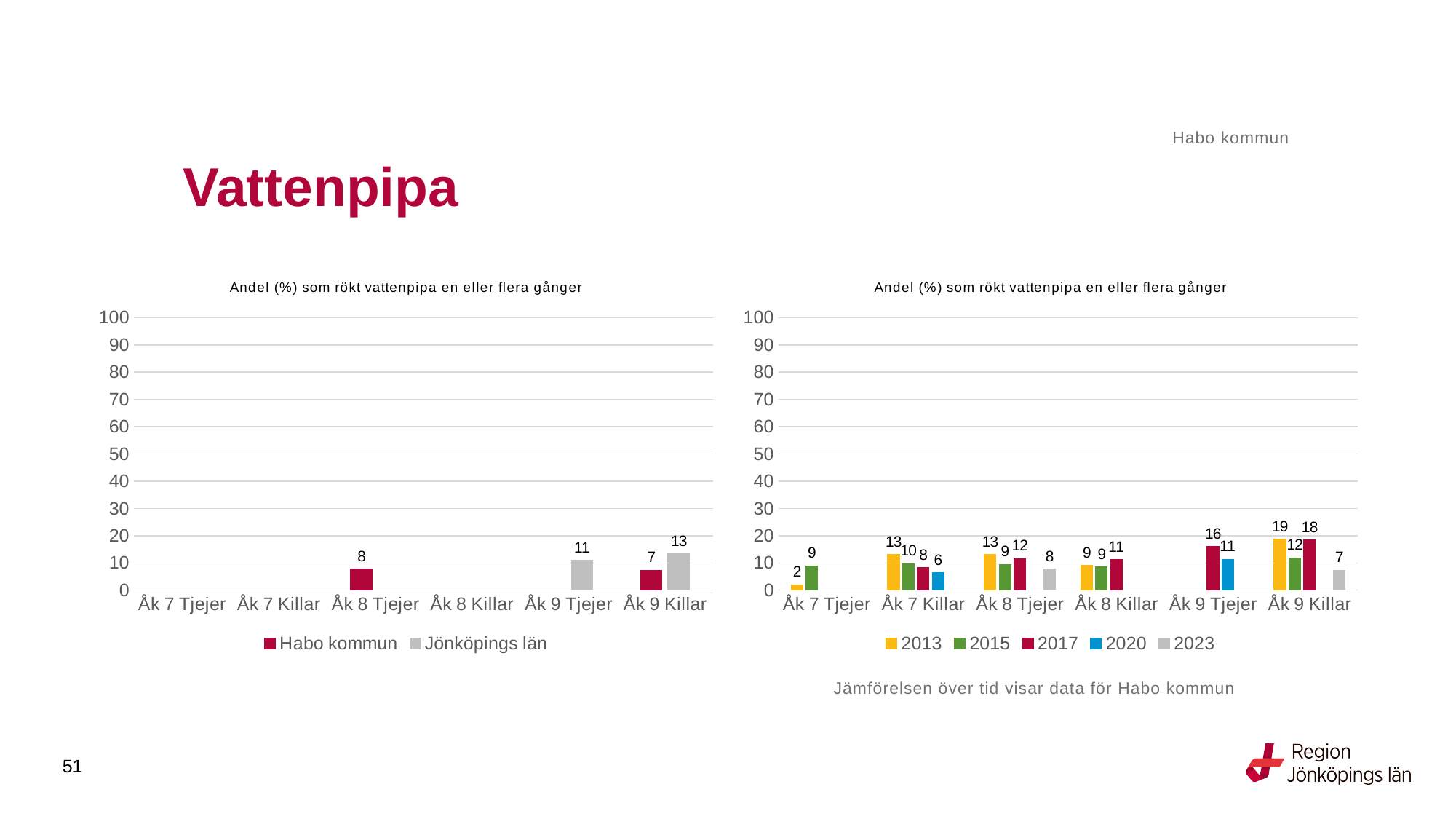
In the left chart, what is the difference between Jönköpings län and Habo kommun for Åk 9 Killar? 6 In the right chart, what is the value for 2013 for Åk 9 Killar? 19 In the right chart, what is the value for 2020 for Åk 7 Killar? 6 In the right chart, which year has the highest value for Åk 9 Killar? 2013 In the right chart, which is larger for Åk 8 Tjejer: the value for 2013 or the value for 2015? 2013 In the right chart, which year has the lowest value for Åk 7 Killar? 2020 In the left chart, what is the value for Habo kommun for Åk 8 Tjejer? 8 In the right chart, how many categories are shown on the x axis? 6 In the left chart, what kind of chart is shown? Bar chart In the left chart, how many series does the legend list? 2 In the right chart, how many series does the legend list? 5 In the left chart, what is the value for Jönköpings län for Åk 9 Killar? 13